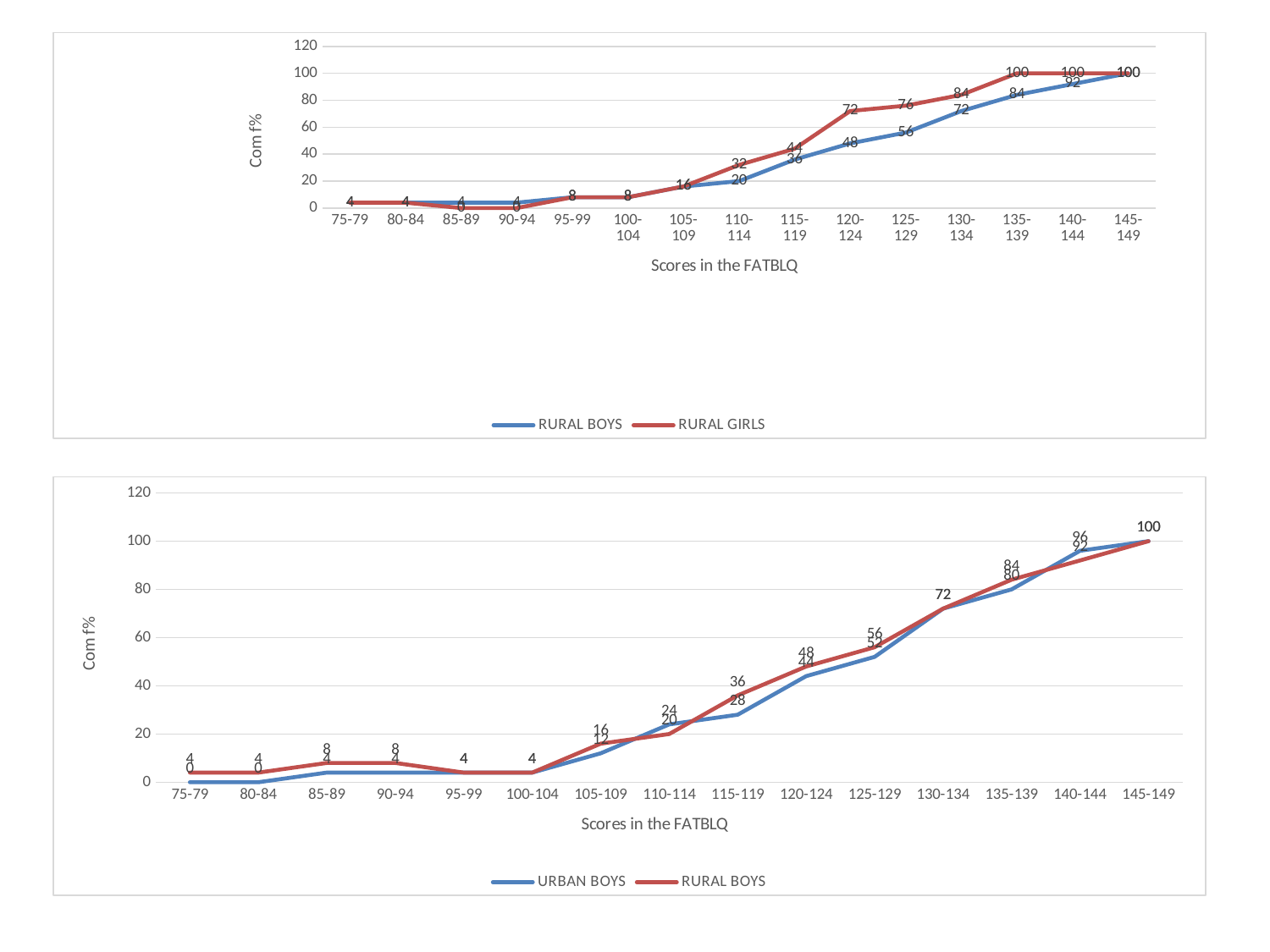
In the top chart, what is the difference between RURAL GIRLS and RURAL BOYS at 125-129? 20 In the top chart, what is the value for RURAL GIRLS at 120-124? 72 What kind of chart is the top chart on the slide? Line chart In the top chart, what is the value for RURAL BOYS at 130-134? 72 In the bottom chart, what is the value for RURAL BOYS at 115-119? 36 In the bottom chart, what is the value for URBAN BOYS at 140-144? 96 In the top chart, which series has the higher value at 115-119, RURAL BOYS or RURAL GIRLS? RURAL GIRLS In the bottom chart, do the values for URBAN BOYS generally rise or fall from 75-79 to 145-149? Rise In the bottom chart, which series has the higher value at 110-114, URBAN BOYS or RURAL BOYS? URBAN BOYS How many series does the legend of the top chart list? 2 What is the x-axis title of the bottom chart? Scores in the FATBLQ How many score categories are shown on the x axis of the bottom chart? 15